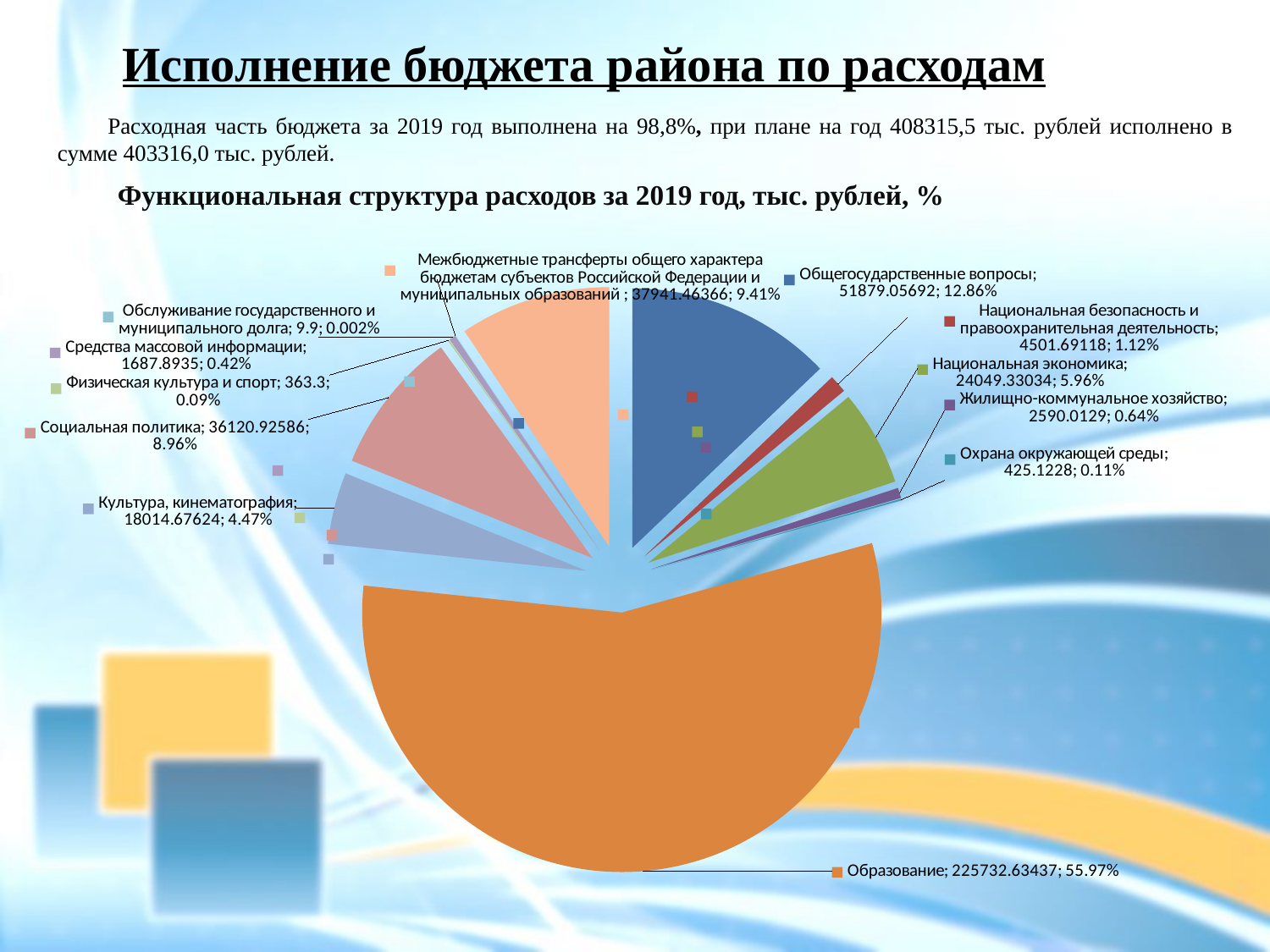
Which is larger: the share for Национальная экономика or the share for Культура, кинематография? Национальная экономика What share of the pie does Образование account for? 55.97% Which category has the largest slice in the pie chart? Образование Which category has the smallest slice in the pie chart? Обслуживание государственного и муниципального долга What percentage is shown for Охрана окружающей среды? 0.11% What is the difference in percentage points between the shares of Общегосударственные вопросы (12.86%) and Социальная политика (8.96%)? 3.9 How many categories (slices) does the pie chart show? 12 What is the value shown for Социальная политика? 36120.92586 What is the value shown for Образование in the pie chart? 225732.63437 What kind of chart is shown on the slide? pie chart What percentage is shown for Общегосударственные вопросы? 12.86% What is the title of the pie chart? Функциональная структура расходов за 2019 год, тыс. рублей, %